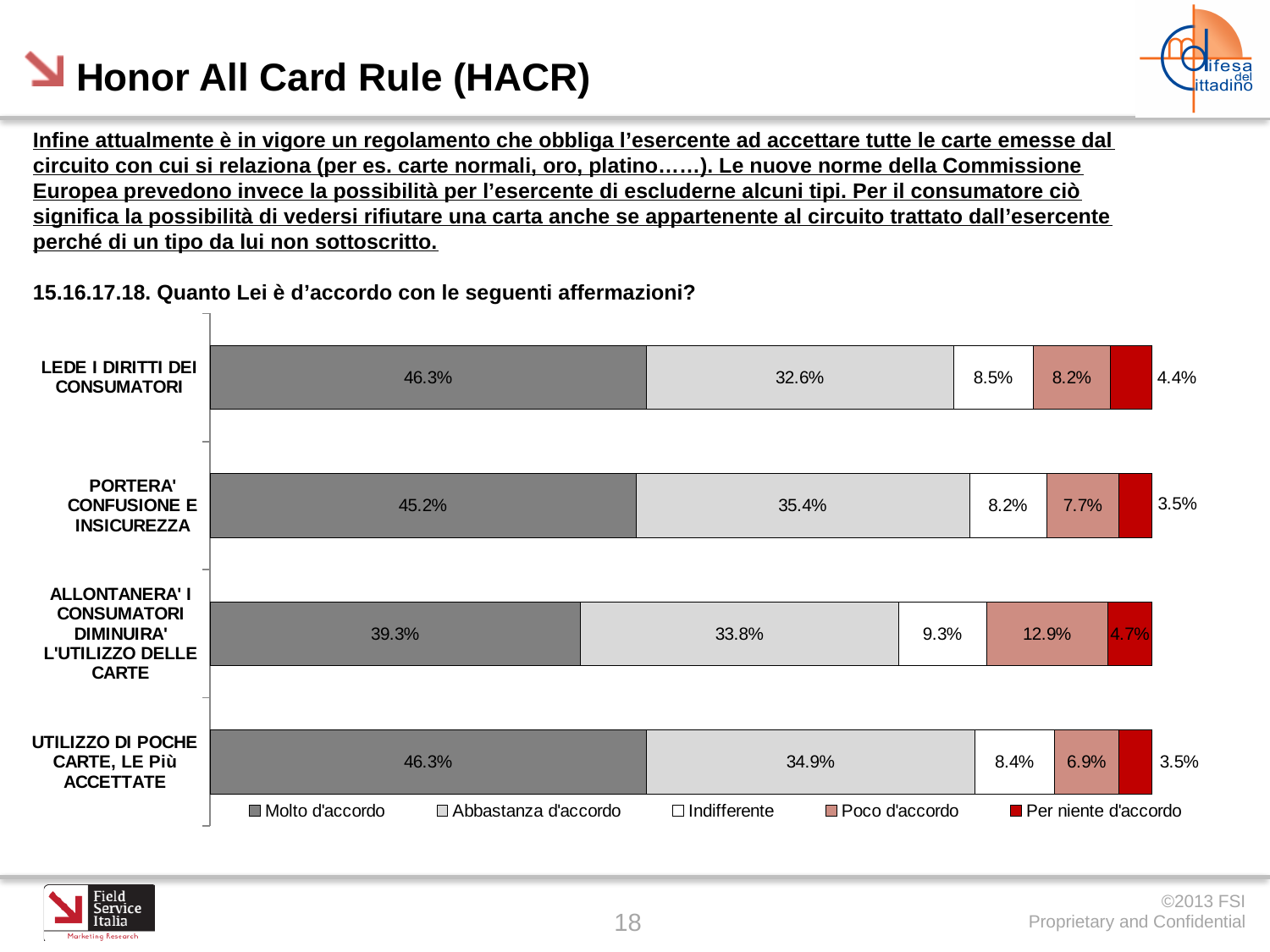
What is the difference between the 'Poco d'accordo' values for 'ALLONTANERA' I CONSUMATORI DIMINUIRA' L'UTILIZZO DELLE CARTE' and 'UTILIZZO DI POCHE CARTE, LE PIù ACCETTATE'? 6.0 percentage points What is the 'Poco d'accordo' value for 'ALLONTANERA' I CONSUMATORI DIMINUIRA' L'UTILIZZO DELLE CARTE'? 12.9% Which statement has the lowest 'Molto d'accordo' value? ALLONTANERA' I CONSUMATORI DIMINUIRA' L'UTILIZZO DELLE CARTE What is the 'Molto d'accordo' value for 'PORTERA' CONFUSIONE E INSICUREZZA'? 45.2% What colour represents 'Per niente d'accordo' in the legend? Red What is the 'Per niente d'accordo' value for 'UTILIZZO DI POCHE CARTE, LE PIù ACCETTATE'? 3.5% How many statements (categories) are shown in the chart? 4 Which is larger: the 'Per niente d'accordo' value for 'LEDE I DIRITTI DEI CONSUMATORI' or for 'PORTERA' CONFUSIONE E INSICUREZZA'? LEDE I DIRITTI DEI CONSUMATORI How many series does the legend list? 5 What type of chart is shown on the slide? Stacked bar chart Which statement has the highest 'Abbastanza d'accordo' value? PORTERA' CONFUSIONE E INSICUREZZA What is the 'Indifferente' value for 'LEDE I DIRITTI DEI CONSUMATORI'? 8.5%